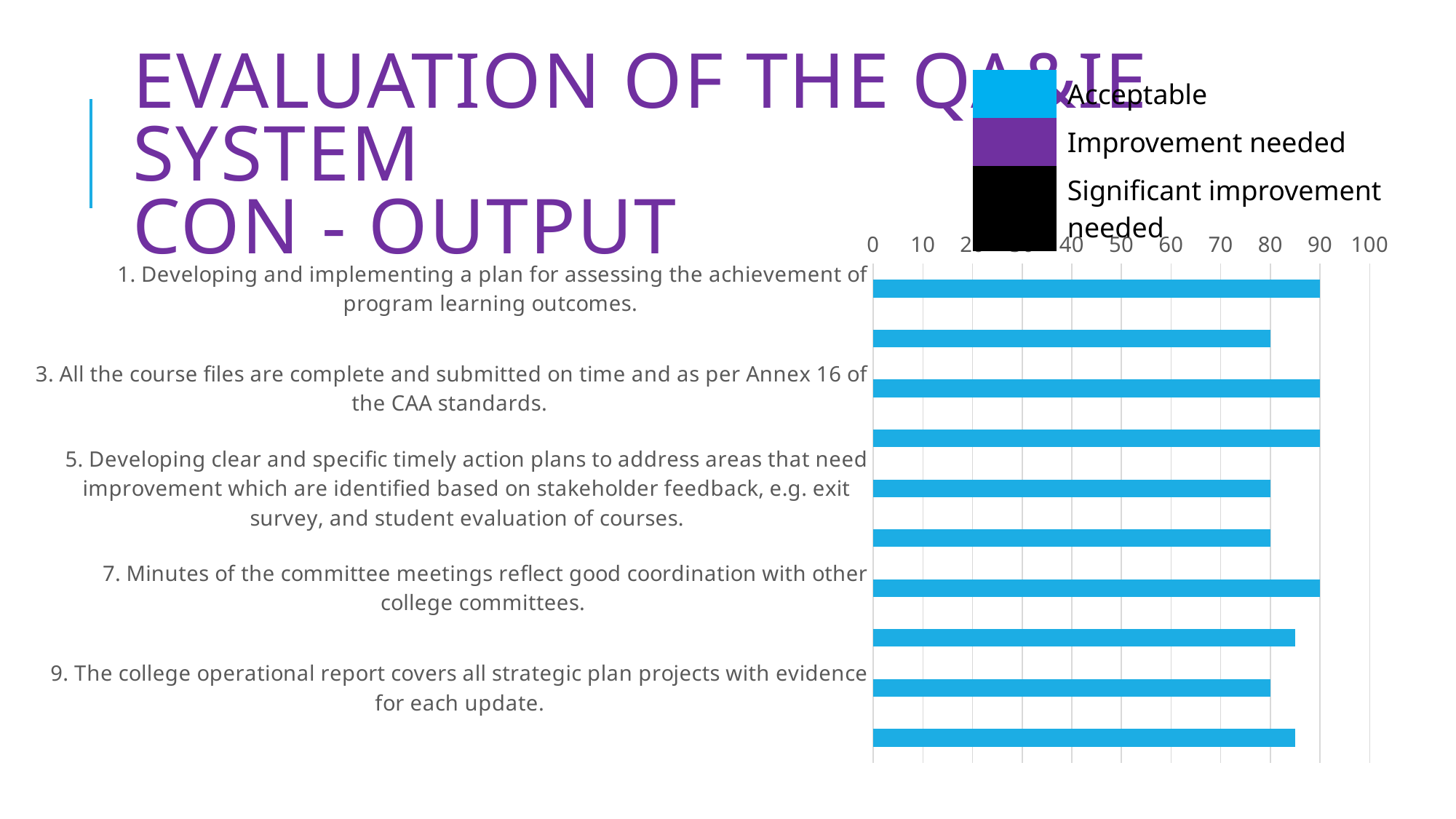
What is the difference between the value for item 1 and the value for item 9? 10 Which has the larger value: item 1 (plan for assessing program learning outcomes) or item 5 (timely action plans)? item 1 What is the value for item 1, 'Developing and implementing a plan for assessing the achievement of program learning outcomes'? 90 How many entries does the chart legend list? 3 Is the value for item 9 (college operational report) greater or less than 90? less What is the value for item 5, 'Developing clear and specific timely action plans to address areas that need improvement'? 80 What is the value for item 9, 'The college operational report covers all strategic plan projects with evidence for each update'? 80 How many bars are plotted in the chart? 10 Which legend entry is shown in blue? Acceptable What is the value for item 3, 'All the course files are complete and submitted on time and as per Annex 16 of the CAA standards'? 90 What type of chart is shown on the slide? bar chart What is the value for item 7, 'Minutes of the committee meetings reflect good coordination with other college committees'? 90